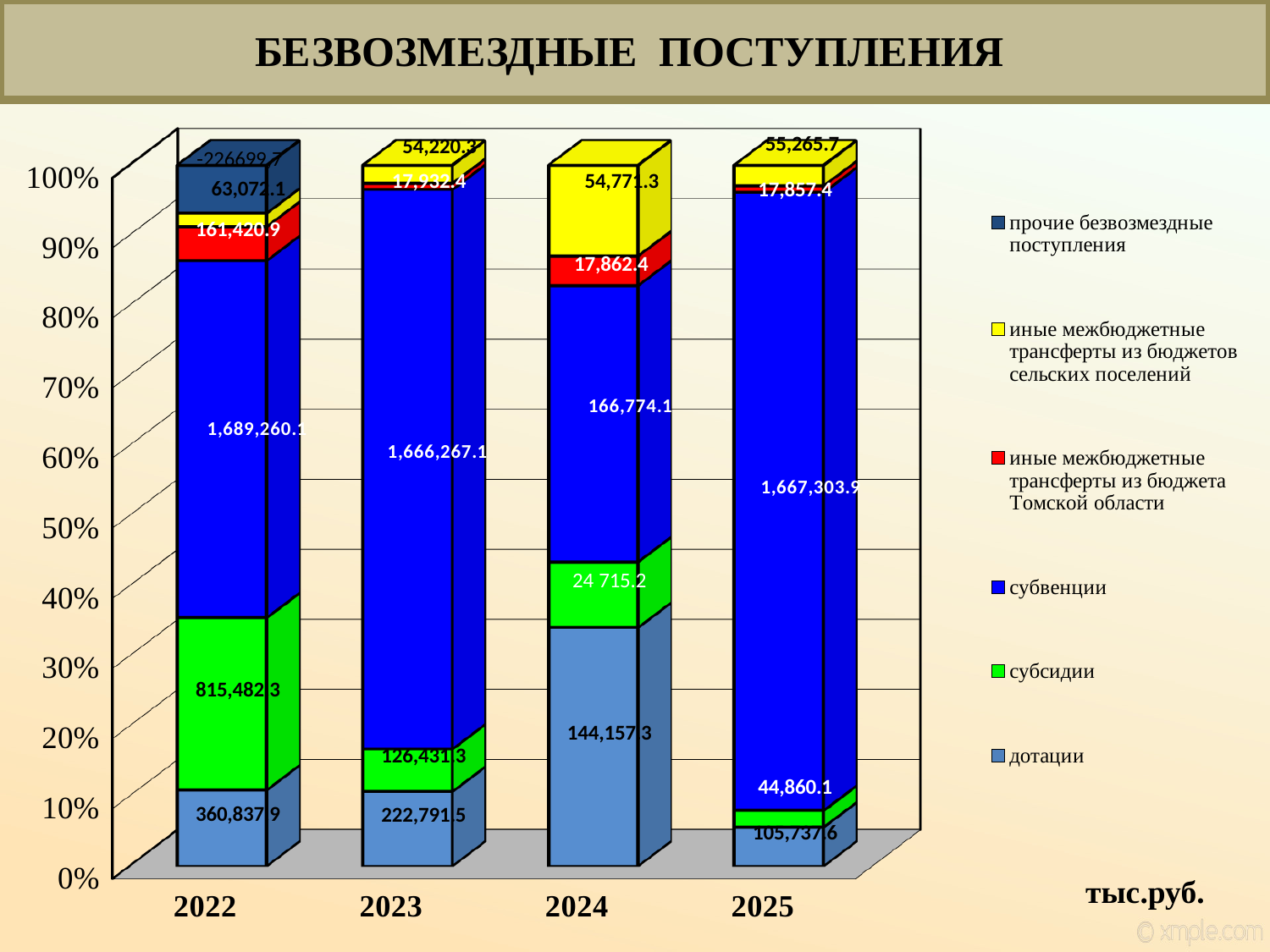
What is the value for субсидии in 2025? 44,860.1 In which year is the value for субсидии highest? 2022 Do the values for дотации rise or fall from 2022 to 2025? fall What is the difference between the дотации values for 2023 and 2024? 78,634.2 In which year is the value for дотации lowest? 2025 Which is larger: субсидии in 2024 or субсидии in 2025? субсидии in 2025 How many series does the legend list? 6 What is the value for иные межбюджетные трансферты из бюджета Томской области in 2025? 17,857.4 What kind of chart is shown on the slide? stacked bar chart What is the value for дотации in 2024? 144,157.3 What is the value for иные межбюджетные трансферты из бюджетов сельских поселений in 2024? 54,771.3 What is the value for субвенции in 2023? 1,666,267.1